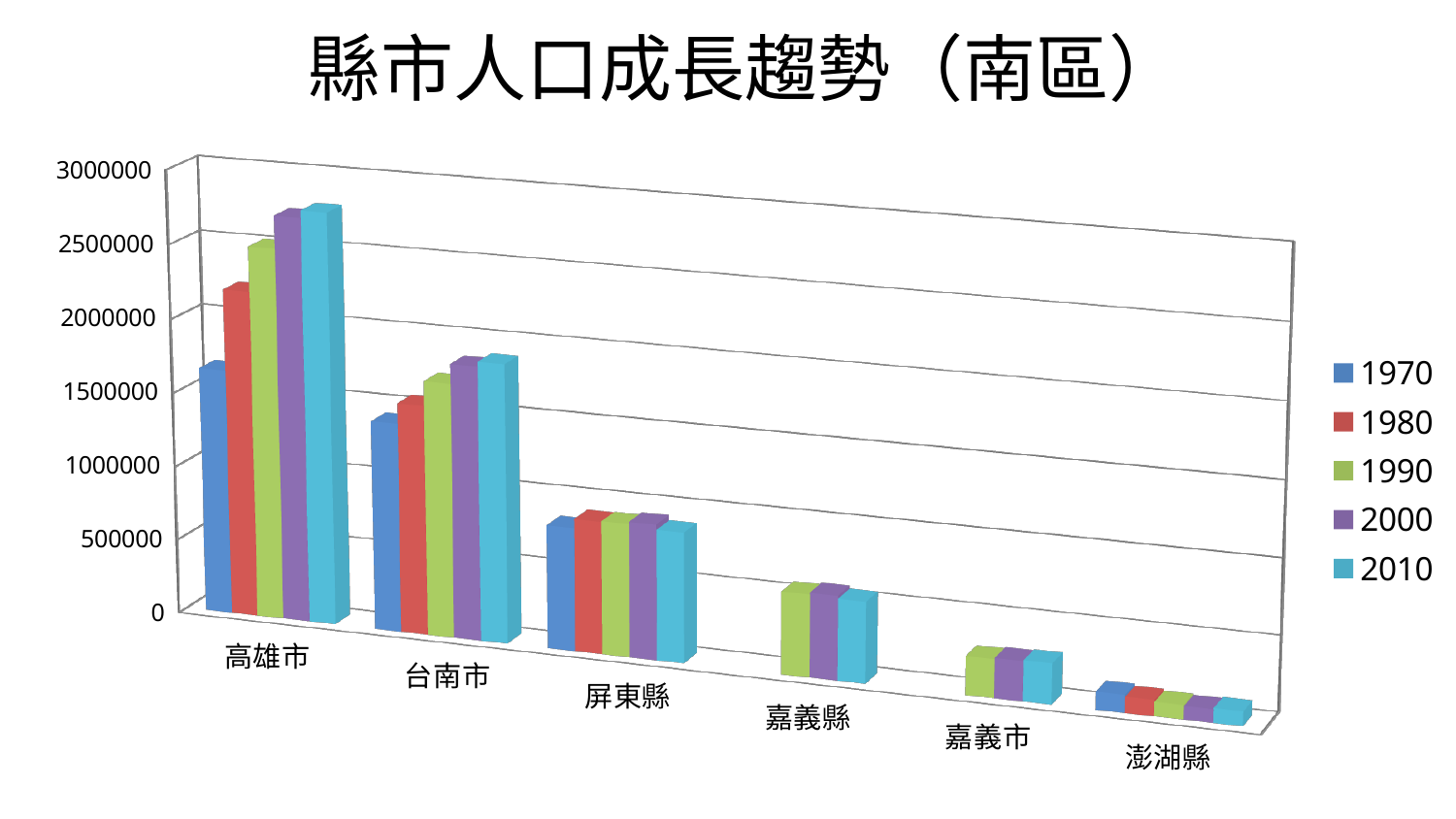
Which is larger in 2010, the value for 高雄市 or the value for 台南市? 高雄市 How many series does the legend list? 5 How many categories (counties/cities) are shown on the x axis? 6 What kind of chart is shown on the slide? bar chart Which colour represents the 1970 series in the legend? blue Is the value for 高雄市 in 1970 greater or less than 1000000? greater Which category has the highest population values in the chart? 高雄市 Do the values for 高雄市 rise or fall from 1970 to 2010? rise Is the value for 屏東縣 in 2010 greater or less than 1000000? less Which category has the lowest population values in the chart? 澎湖縣 What is the title of the chart? 縣市人口成長趨勢（南區）